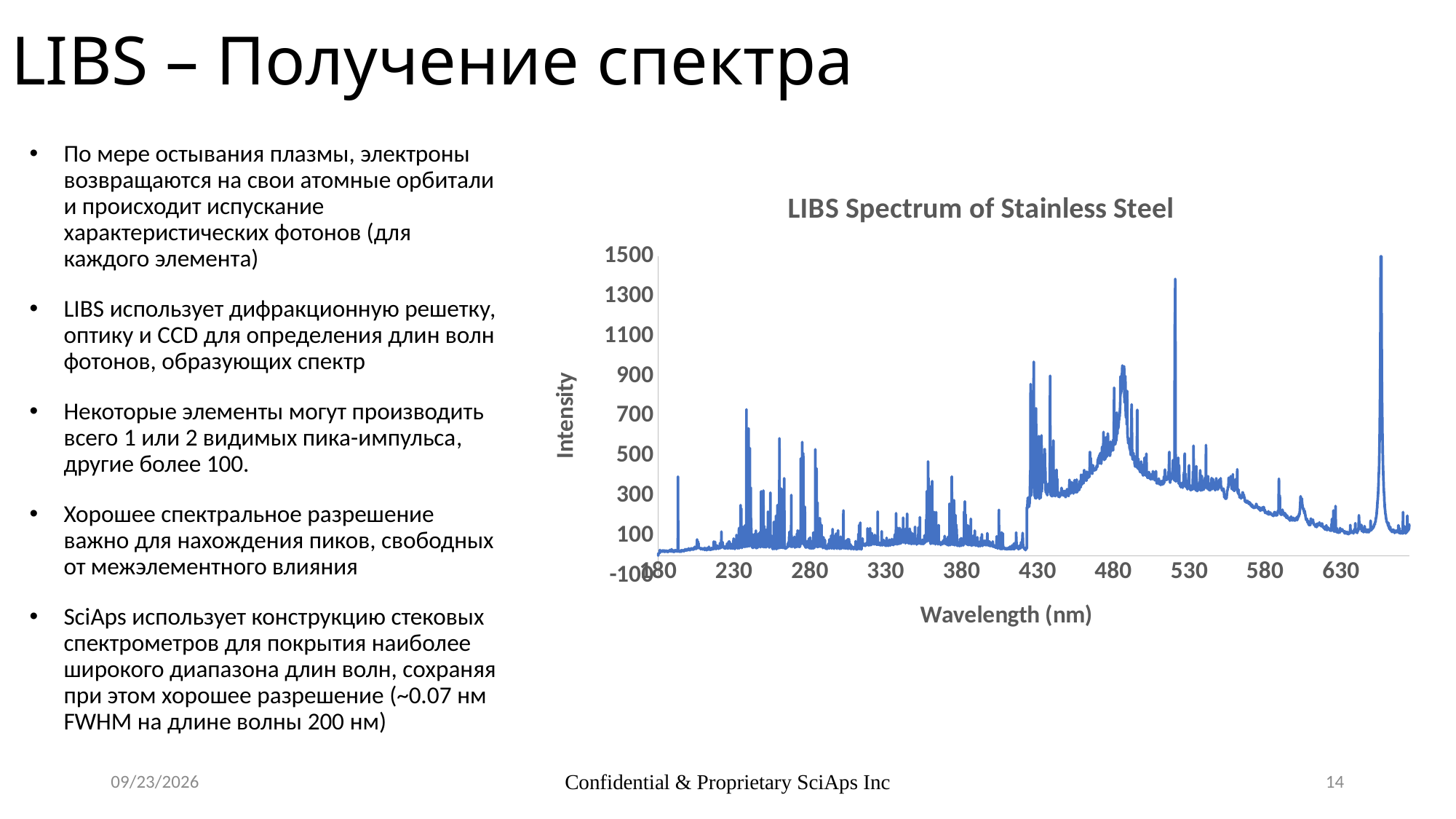
Is the tallest peak in the spectrum located at a wavelength greater or less than 630 nm? greater Is the intensity of the tallest peak (near the right end of the spectrum) greater or less than 1300? greater How many tick labels are shown on the Wavelength (nm) axis? 10 What is the label of the x axis of the chart? Wavelength (nm) Is the intensity of the spectrum around 400 nm greater or less than 300? less Which has the higher intensity: the peak near 235 nm or the peak near 520 nm? the peak near 520 nm What is the highest value shown on the Intensity axis? 1500 What kind of chart is shown on the slide? line chart What is the title of the chart? LIBS Spectrum of Stainless Steel